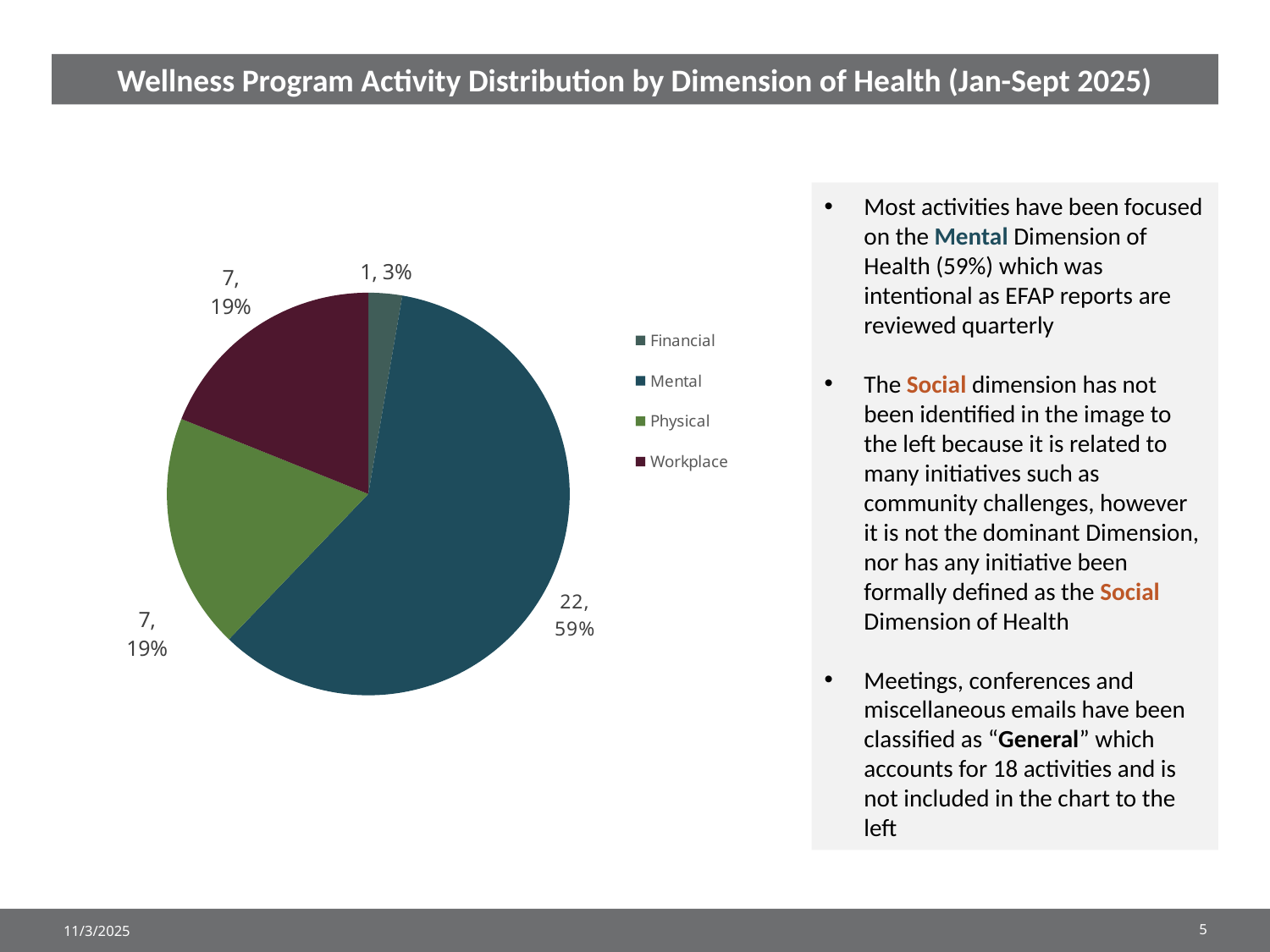
What is the difference between the Mental value and the Workplace value? 15 What share of the pie does the Mental slice represent? 59% What share of the pie does the Financial slice represent? 3% What kind of chart is shown on the slide? pie chart What is the value for Physical in the pie chart? 7 What is the value for Financial in the pie chart? 1 What is the title of the slide containing the pie chart? Wellness Program Activity Distribution by Dimension of Health (Jan-Sept 2025) Which category has the largest slice in the pie chart? Mental How many categories does the pie chart legend list? 4 What share of the pie does the Workplace slice represent? 19% Which category has the smallest slice in the pie chart? Financial What is the value for Mental in the pie chart? 22